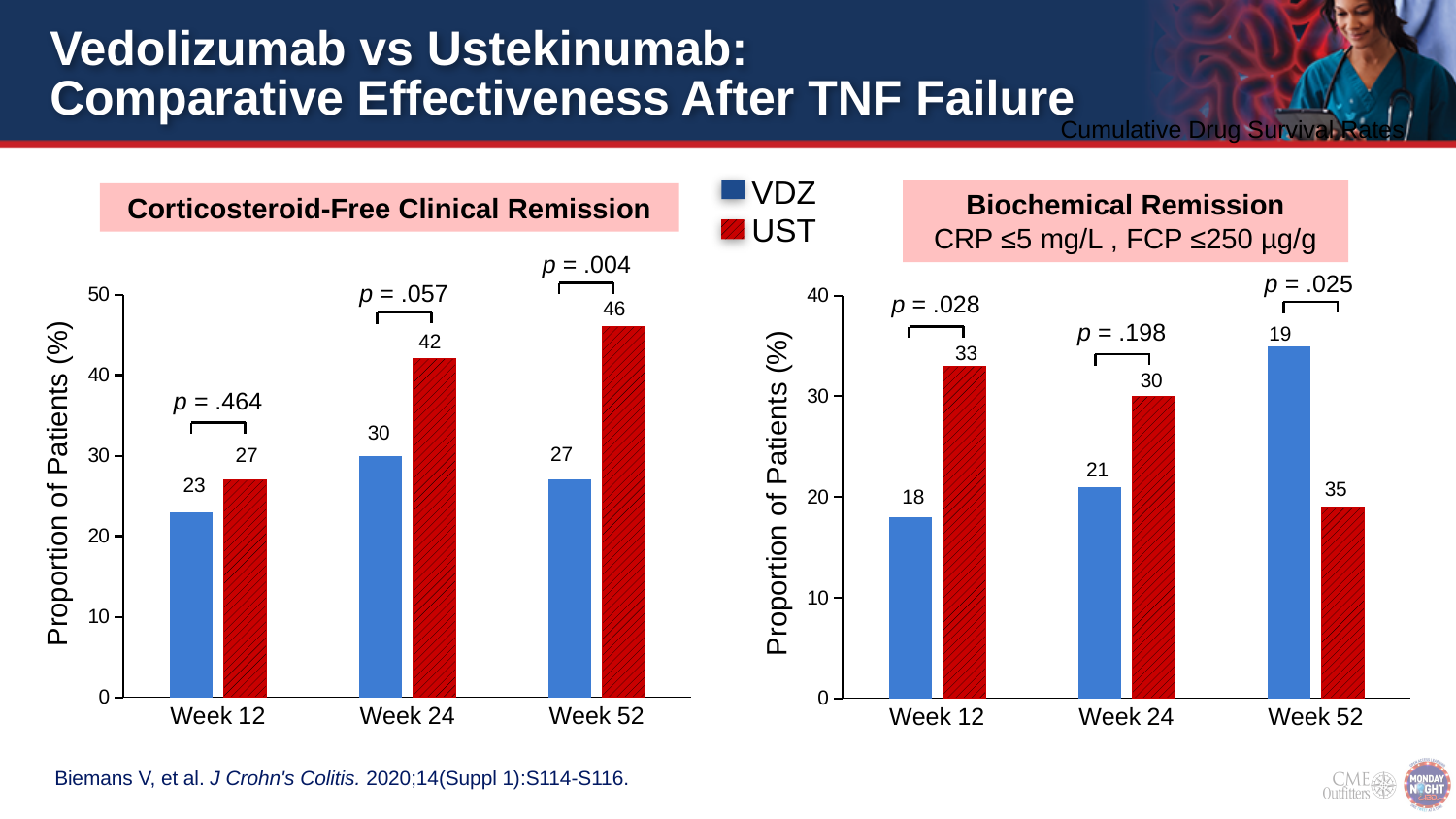
In the Corticosteroid-Free Clinical Remission chart, which bar is the lowest? VDZ at Week 12 In the Corticosteroid-Free Clinical Remission chart, which bar is the highest? UST at Week 52 In the Biochemical Remission chart, what is the value for VDZ at Week 24? 21 In the Corticosteroid-Free Clinical Remission chart, what is the value for VDZ at Week 24? 30 In the Corticosteroid-Free Clinical Remission chart, what is the difference between UST and VDZ at Week 24? 12 How many series does the legend list? 2 In the Biochemical Remission chart, what is the difference between UST and VDZ at Week 12? 15 In the Biochemical Remission chart, which is larger at Week 12, VDZ or UST? UST In the Corticosteroid-Free Clinical Remission chart, what is the value for UST at Week 52? 46 In the Biochemical Remission chart, what is the value for UST at Week 12? 33 In the Corticosteroid-Free Clinical Remission chart, do the UST values rise or fall from Week 12 to Week 52? rise What kind of chart is the Corticosteroid-Free Clinical Remission chart? bar chart